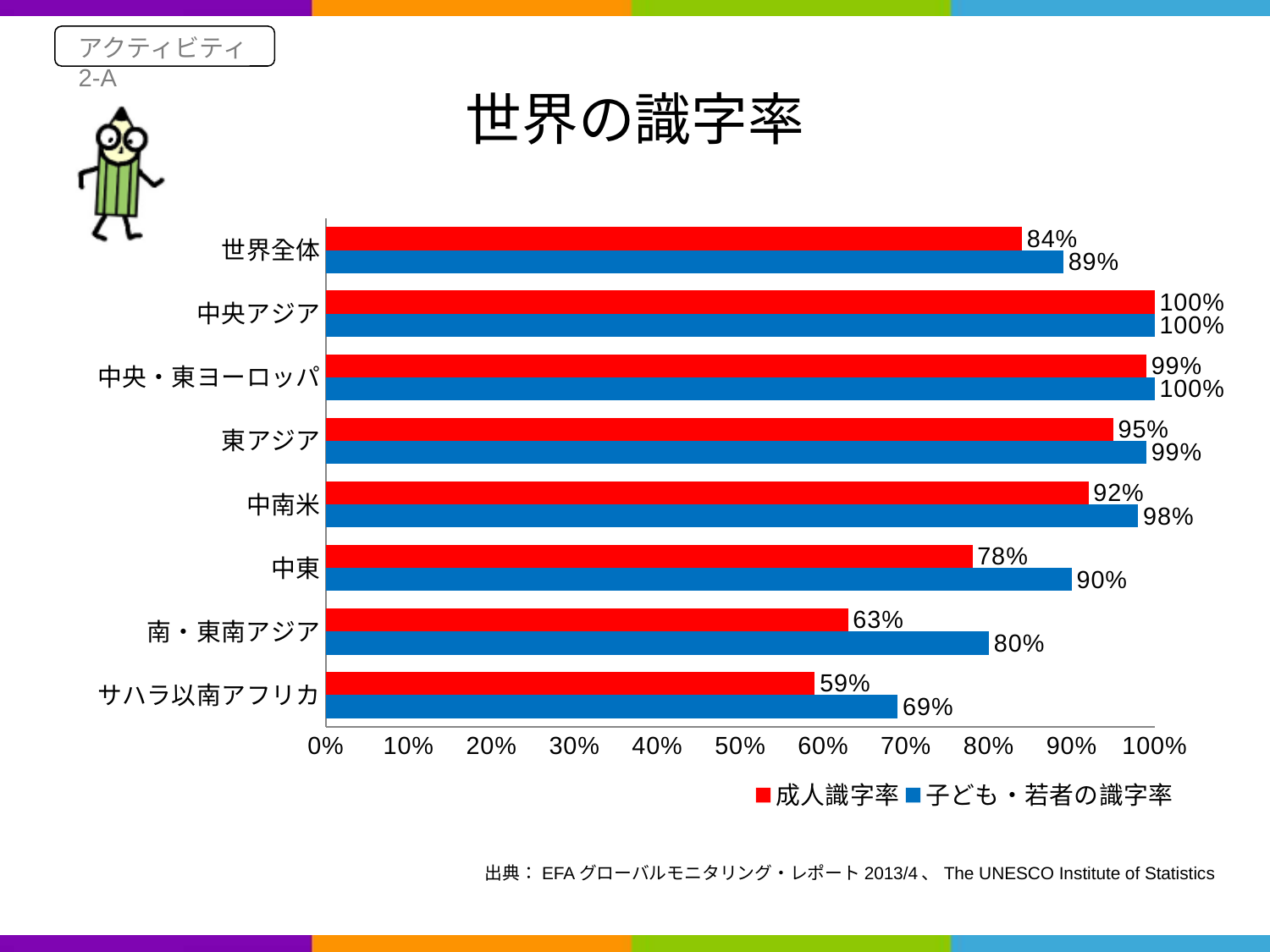
What is the difference between the 子ども・若者の識字率 and the 成人識字率 for 南・東南アジア? 17% What is the 子ども・若者の識字率 for 中東? 90% Which is larger: the 成人識字率 of 中南米 or the 成人識字率 of 中東? 中南米 Which region has the lowest 成人識字率? サハラ以南アフリカ What is the difference between the 成人識字率 of 東アジア and that of 中東? 17% What is the 子ども・若者の識字率 (youth literacy rate) for サハラ以南アフリカ? 69% What is the 成人識字率 (adult literacy rate) for 世界全体? 84% How many regions (categories) are shown on the chart? 8 What type of chart is shown on the slide? Bar chart Which region has the lowest 子ども・若者の識字率? サハラ以南アフリカ What is the 成人識字率 for 南・東南アジア? 63% How many series does the legend list? 2